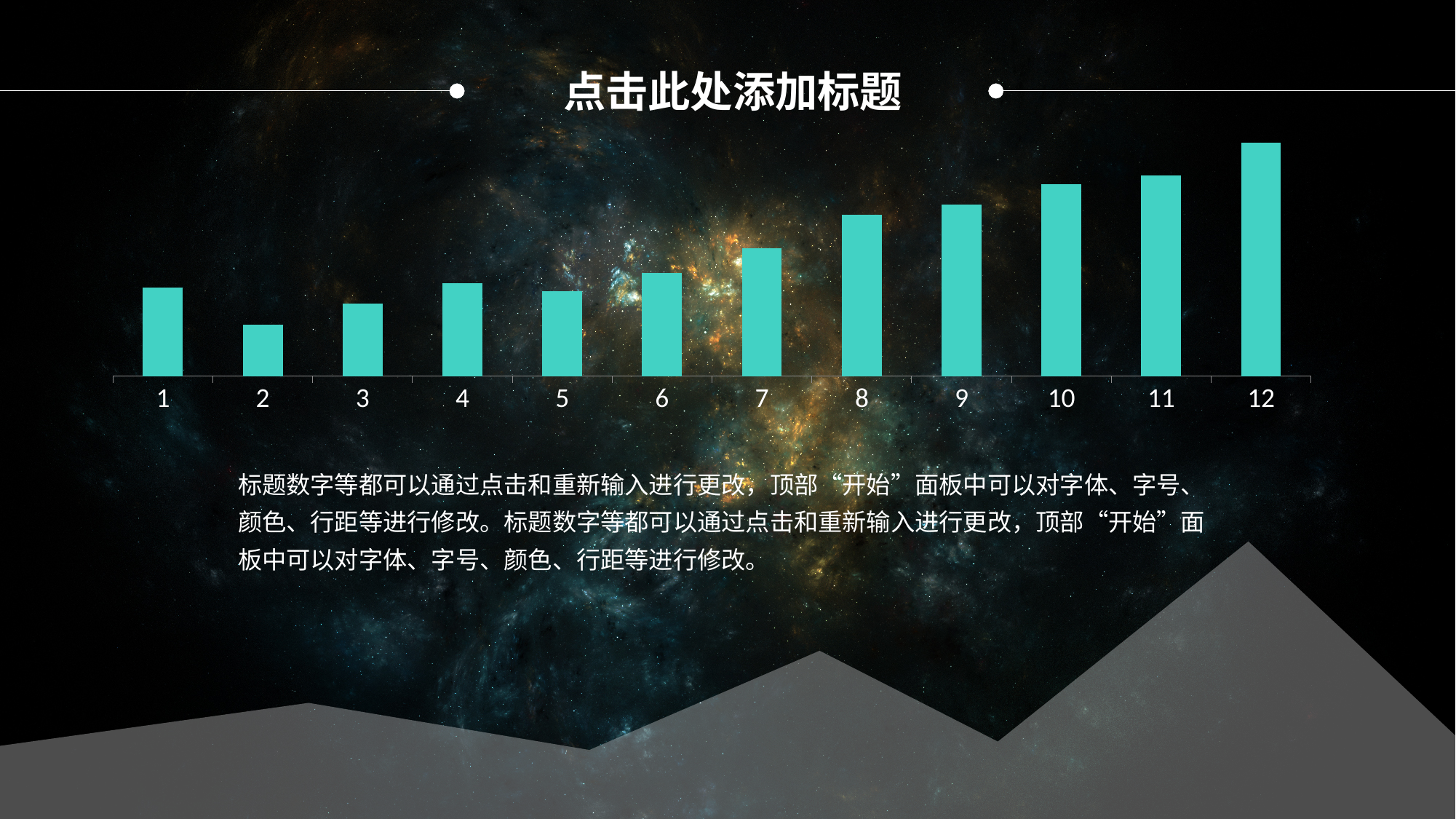
What is the title text shown above the chart? 点击此处添加标题 Which bar is taller, category 7 or category 10? 10 What colour are the bars in the chart? teal Which bar is taller, category 2 or category 8? 8 Which bar is taller, category 12 or category 1? 12 Which category has the highest bar in the chart? 12 Do the bar values generally rise or fall from category 1 to category 12? rise How many categories are shown on the x axis of the chart? 12 Which category has the lowest bar in the chart? 2 What kind of chart is shown on the slide? bar chart